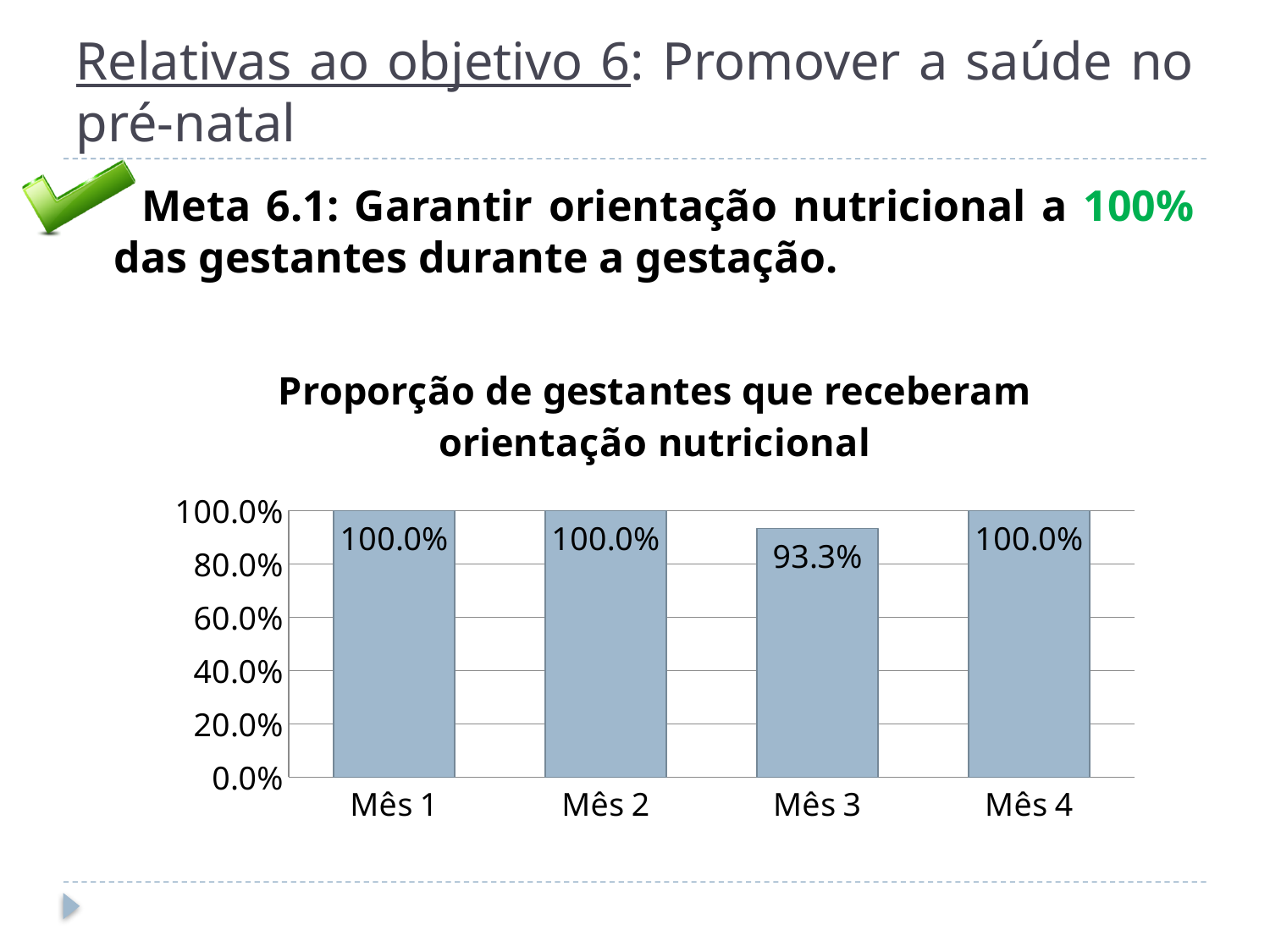
Is the value for Mês 3 greater or less than 80.0%? greater How many months have a value of 100.0%? 3 What is the value for Mês 3? 93.3% Which is larger, the value for Mês 3 or the value for Mês 4? Mês 4 How many months are shown on the x axis? 4 What is the value for Mês 4? 100.0% What is the title of the chart? Proporção de gestantes que receberam orientação nutricional What is the highest value shown on the y axis? 100.0% What is the difference between the values for Mês 2 and Mês 3? 6.7% What is the value for Mês 1? 100.0% What kind of chart is shown on the slide? bar chart Which month has the lowest value? Mês 3